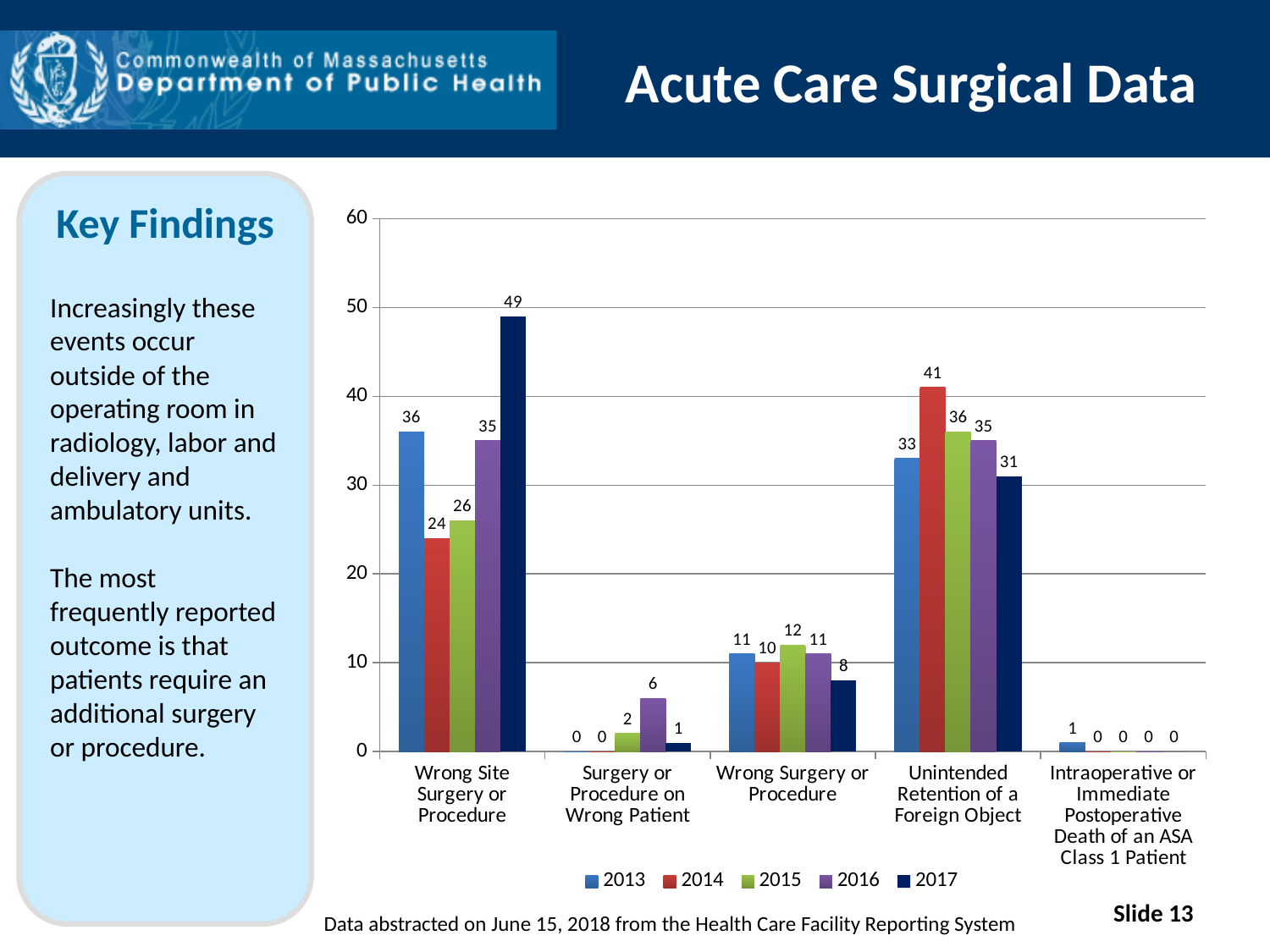
Which year has the lowest value for Unintended Retention of a Foreign Object? 2017 What is the value for Wrong Surgery or Procedure in 2015? 12 How many series does the legend list? 5 What is the value for Wrong Site Surgery or Procedure in 2017? 49 What kind of chart is shown on the slide? Bar chart What is the value for Unintended Retention of a Foreign Object in 2014? 41 Which year has the highest value for Wrong Site Surgery or Procedure? 2017 What is the value for Surgery or Procedure on Wrong Patient in 2016? 6 What is the value for Intraoperative or Immediate Postoperative Death of an ASA Class 1 Patient in 2013? 1 How many event categories are shown on the x axis? 5 Which is larger for Unintended Retention of a Foreign Object: the 2013 value or the 2015 value? 2015 What is the difference between the 2017 and 2013 values for Wrong Site Surgery or Procedure? 13